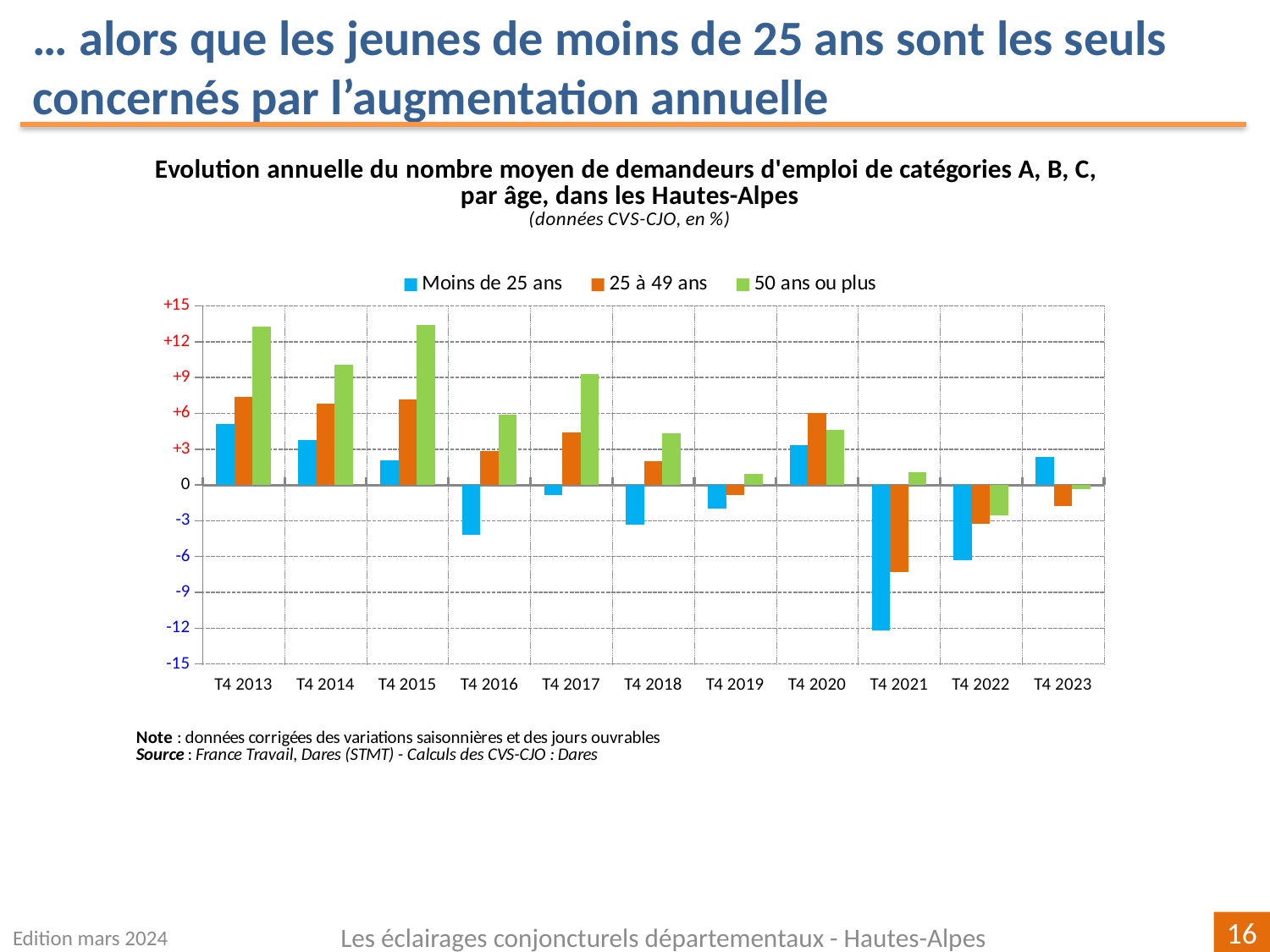
Is the value for '50 ans ou plus' in T4 2013 greater or less than 9? greater How many series does the legend list? 3 Is the value for '25 à 49 ans' in T4 2021 greater or less than -6? less In T4 2016, which is larger: the value for 'Moins de 25 ans' or for '50 ans ou plus'? 50 ans ou plus Is the value for '50 ans ou plus' in T4 2017 greater or less than 6? greater In which period is the value for 'Moins de 25 ans' the lowest? T4 2021 How many periods (categories) are shown on the x axis? 11 In T4 2023, which is larger: the value for 'Moins de 25 ans' or for '25 à 49 ans'? Moins de 25 ans Which colour represents the 'Moins de 25 ans' series in the legend? blue In T4 2020, which is larger: the value for '25 à 49 ans' or for '50 ans ou plus'? 25 à 49 ans What kind of chart is shown on the slide? bar chart